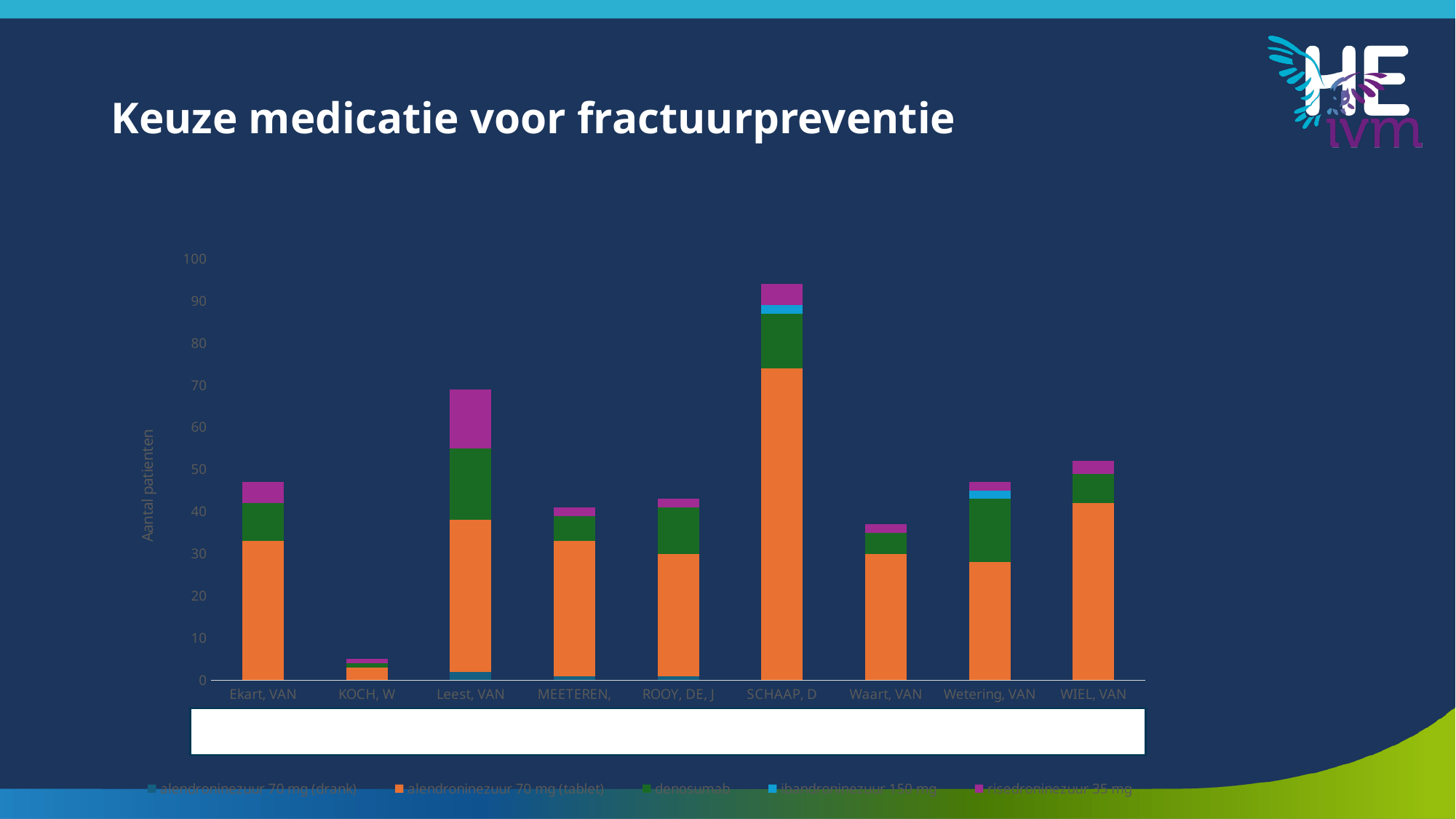
Which has the taller stacked bar, Leest, VAN or Ekart, VAN? Leest, VAN How many series does the chart's legend list? 5 How many categories (prescribers) are shown on the x axis of the chart? 9 Is the total stacked bar for Leest, VAN greater or less than 60? greater What is the title of the slide containing the chart? Keuze medicatie voor fractuurpreventie Which category has the tallest stacked bar in the chart? SCHAAP, D Is the total stacked bar for Waart, VAN greater or less than 40? less What is the label on the vertical axis of the chart? Aantal patienten Is the total stacked bar for SCHAAP, D greater or less than 80? greater Which category has the shortest stacked bar in the chart? KOCH, W What kind of chart is shown on the slide? stacked bar chart